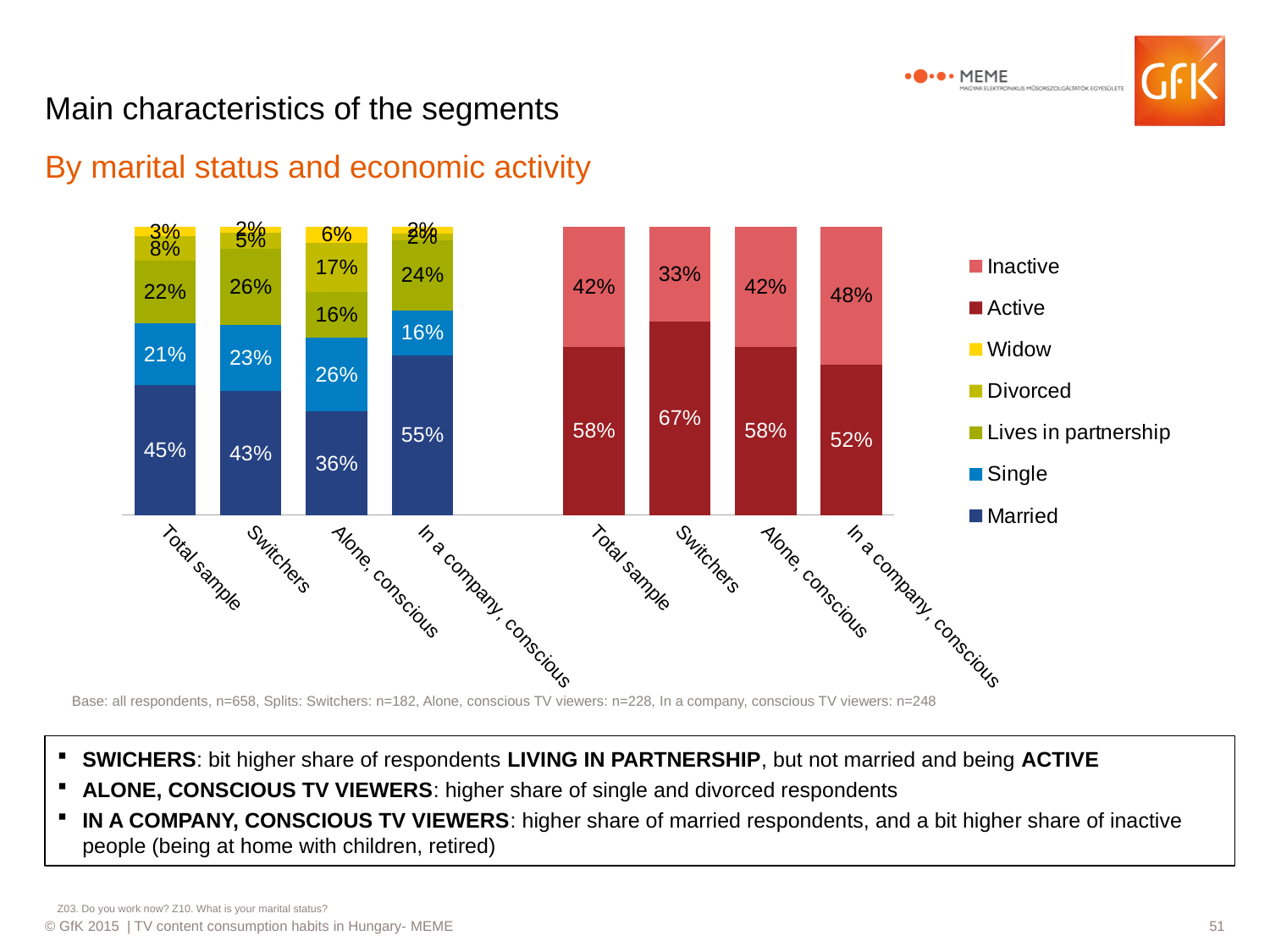
In the right chart (economic activity), what is the Active share for Switchers? 67% What type of chart is used on this slide? Stacked bar chart How many segments (bars) are shown in the left chart (marital status)? 4 In the left chart (marital status), what is the Married share for the Alone, conscious segment? 36% In the right chart (economic activity), which segment has the highest Inactive share? In a company, conscious In the right chart (economic activity), is the Active share larger for Switchers or for the Total sample? Switchers In the left chart (marital status), which segment has the highest Married share? In a company, conscious In the right chart (economic activity), what is the difference between the Active share of Switchers and that of the In a company, conscious segment? 15% In the left chart (marital status), what is the difference between the Divorced share of Alone, conscious and that of the Total sample? 9% In the left chart (marital status), which segment has the lowest Married share? Alone, conscious In the left chart (marital status), what is the Lives in partnership share for the In a company, conscious segment? 24% In the left chart (marital status), what is the Single share for Switchers? 23%